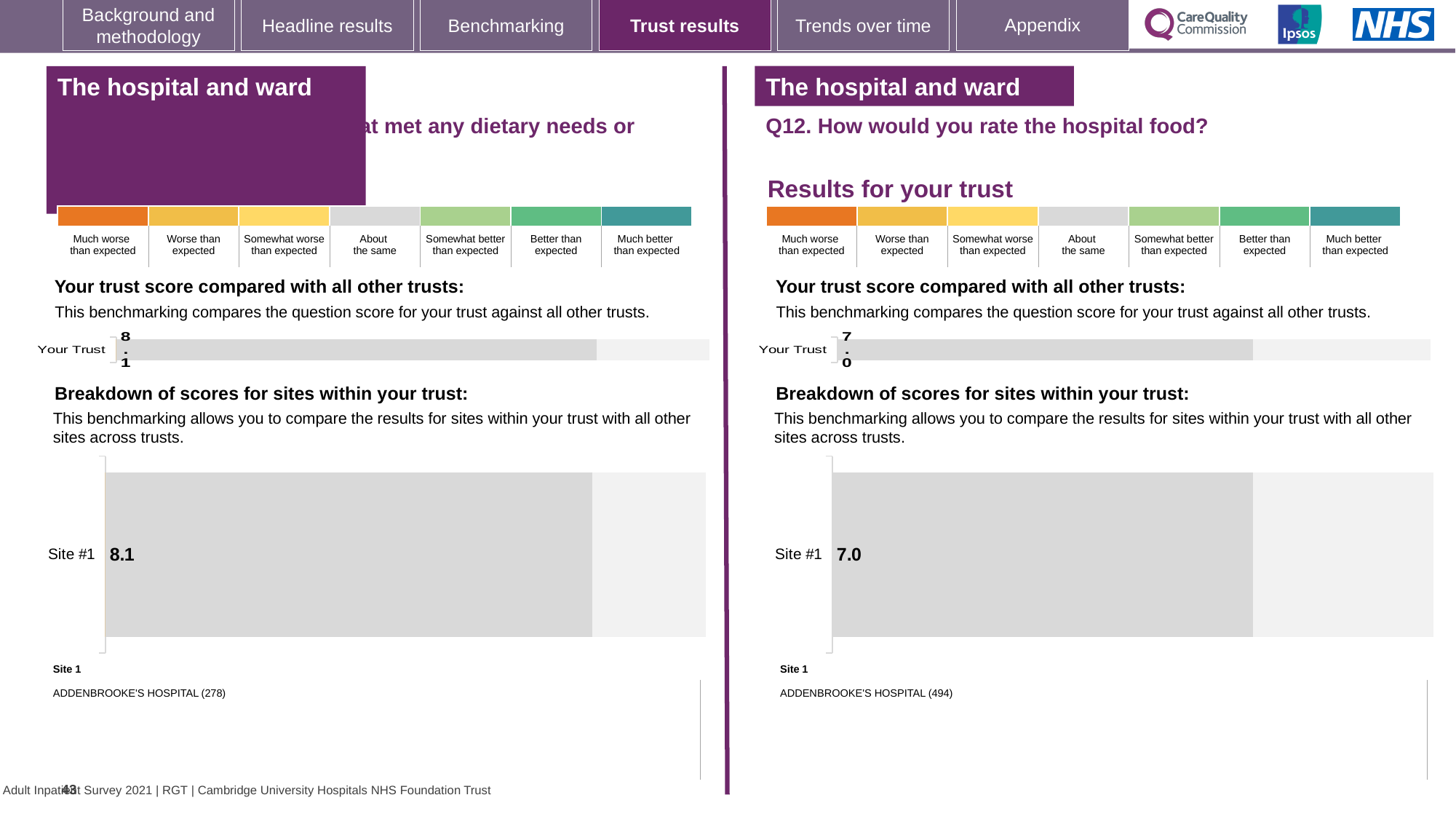
Which site is listed as Site 1 beneath the left-hand breakdown chart? ADDENBROOKE'S HOSPITAL (278) How many sites are shown in the right-hand 'Breakdown of scores for sites within your trust' chart (Q12)? 1 How many sites are shown in the left-hand 'Breakdown of scores for sites within your trust' chart? 1 What type of chart is used for the 'Your Trust' score on the right-hand side (Q12)? Bar chart What type of chart is used for the Site #1 breakdown on the left-hand side of the slide? Bar chart In the right-hand 'Breakdown of scores for sites within your trust' chart (Q12), what is the score for Site #1? 7.0 On the right-hand side (Q12, hospital food), what is the score shown for Your Trust in the 'Your trust score compared with all other trusts' chart? 7.0 Which site is listed as Site 1 beneath the right-hand (Q12) breakdown chart? ADDENBROOKE'S HOSPITAL (494) In the left-hand 'Breakdown of scores for sites within your trust' chart, what is the score for Site #1? 8.1 What is the difference between the Site #1 score in the left-hand breakdown chart (8.1) and the Site #1 score in the right-hand Q12 breakdown chart (7.0)? 1.1 Which is larger: the Site #1 score in the left-hand breakdown chart or the Site #1 score in the right-hand (Q12) breakdown chart? Left-hand chart (8.1) On the left-hand side of the slide, what is the score shown for Your Trust in the 'Your trust score compared with all other trusts' chart? 8.1